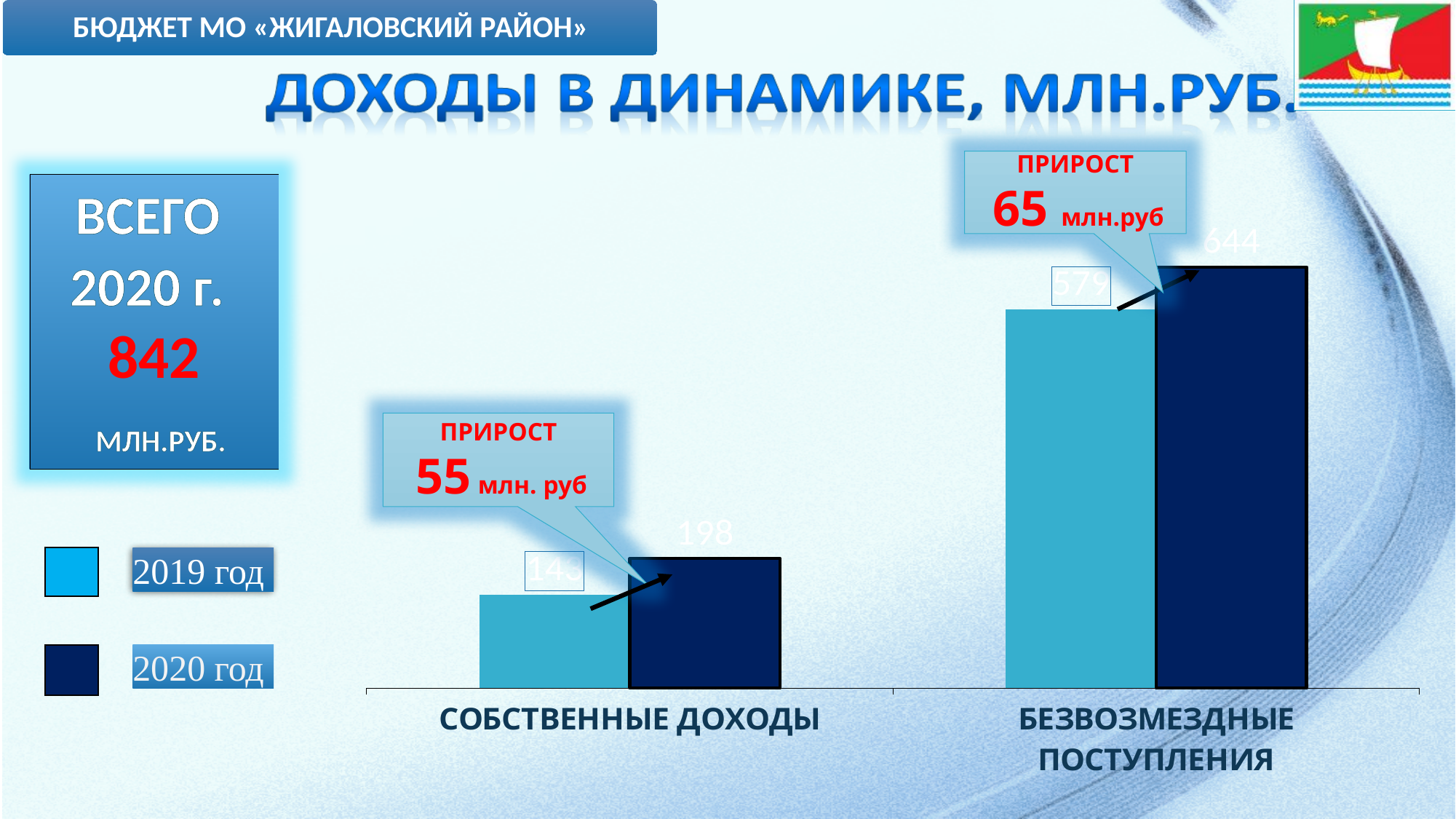
What is the difference between the 2020 год values for БЕЗВОЗМЕЗДНЫЕ ПОСТУПЛЕНИЯ and СОБСТВЕННЫЕ ДОХОДЫ? 446 What is the value for 2020 год in the category БЕЗВОЗМЕЗДНЫЕ ПОСТУПЛЕНИЯ? 644 What is the value for 2020 год in the category СОБСТВЕННЫЕ ДОХОДЫ? 198 What is the title of the chart? ДОХОДЫ В ДИНАМИКЕ, МЛН.РУБ. Which is larger in the category СОБСТВЕННЫЕ ДОХОДЫ: the value for 2019 год or for 2020 год? 2020 год Which category has the highest value for 2020 год? БЕЗВОЗМЕЗДНЫЕ ПОСТУПЛЕНИЯ Which category has the lowest value for 2019 год? СОБСТВЕННЫЕ ДОХОДЫ What is the value for 2019 год in the category СОБСТВЕННЫЕ ДОХОДЫ? 143 What type of chart is shown on the slide? bar chart How many series does the legend list? 2 What is the value for 2019 год in the category БЕЗВОЗМЕЗДНЫЕ ПОСТУПЛЕНИЯ? 579 How many categories are shown on the x axis of the chart? 2